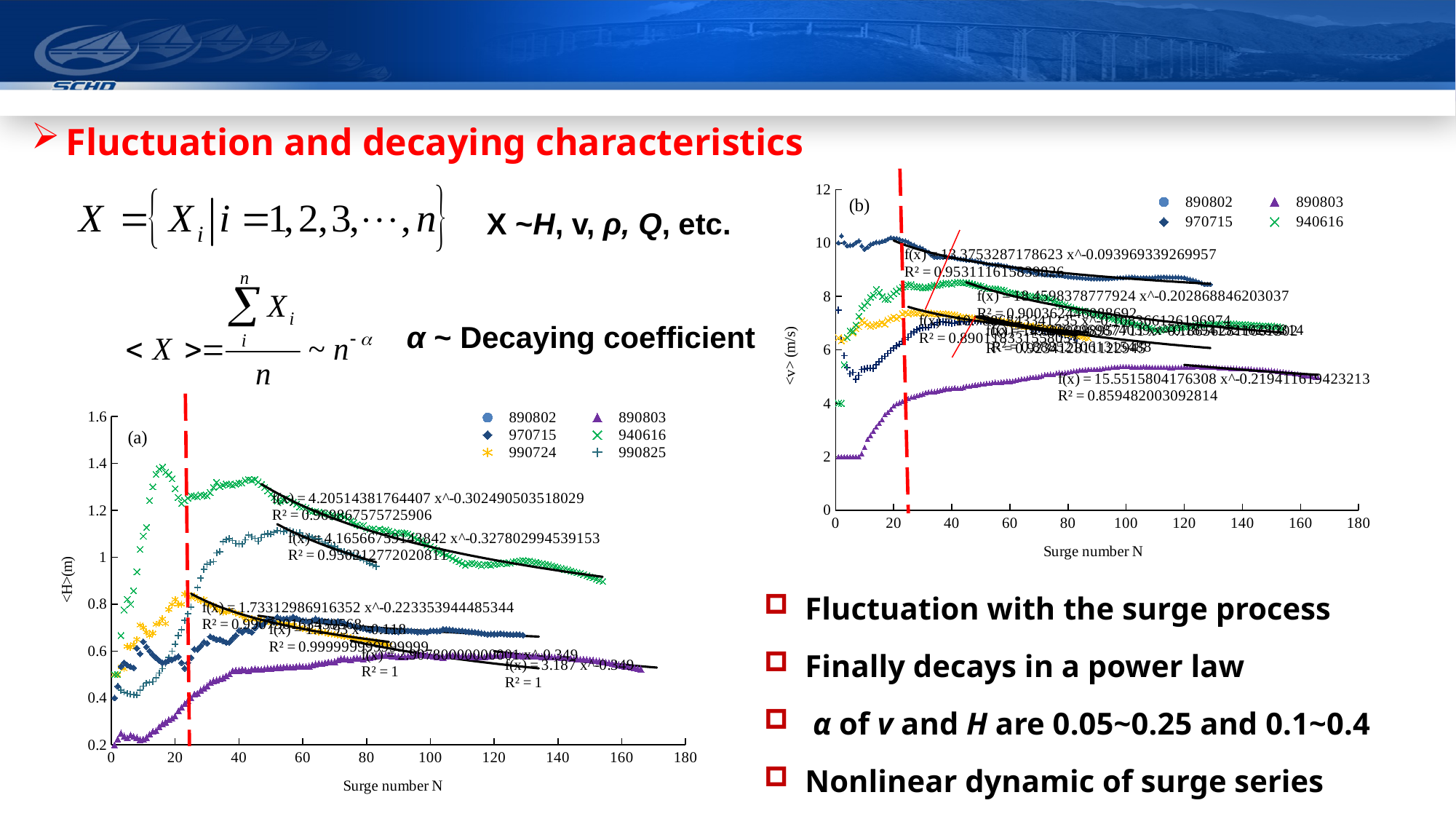
What kind of chart is chart (a), on the left of the slide? scatter chart How many series does the legend of chart (b), on the right, list? 4 In chart (b), on the right, do the values of series 890803 rise or fall as the surge number increases? rise In chart (b), on the right, is the value of series 970715 at surge number 100 greater or less than 8? greater In chart (a), on the left, which series has the lowest value at surge number 20? 890803 In chart (a), on the left, is the value of series 940616 at surge number 150 greater or less than 1? less In chart (a), on the left, is the value of series 940616 at surge number 40 greater or less than 1.2? greater In chart (b), on the right, what is the label of the y axis? <v> (m/s) In chart (b), on the right, which series has the highest value at surge number 100? 970715 In chart (a), on the left, what is the label of the x axis? Surge number N How many series does the legend of chart (a), on the left, list? 6